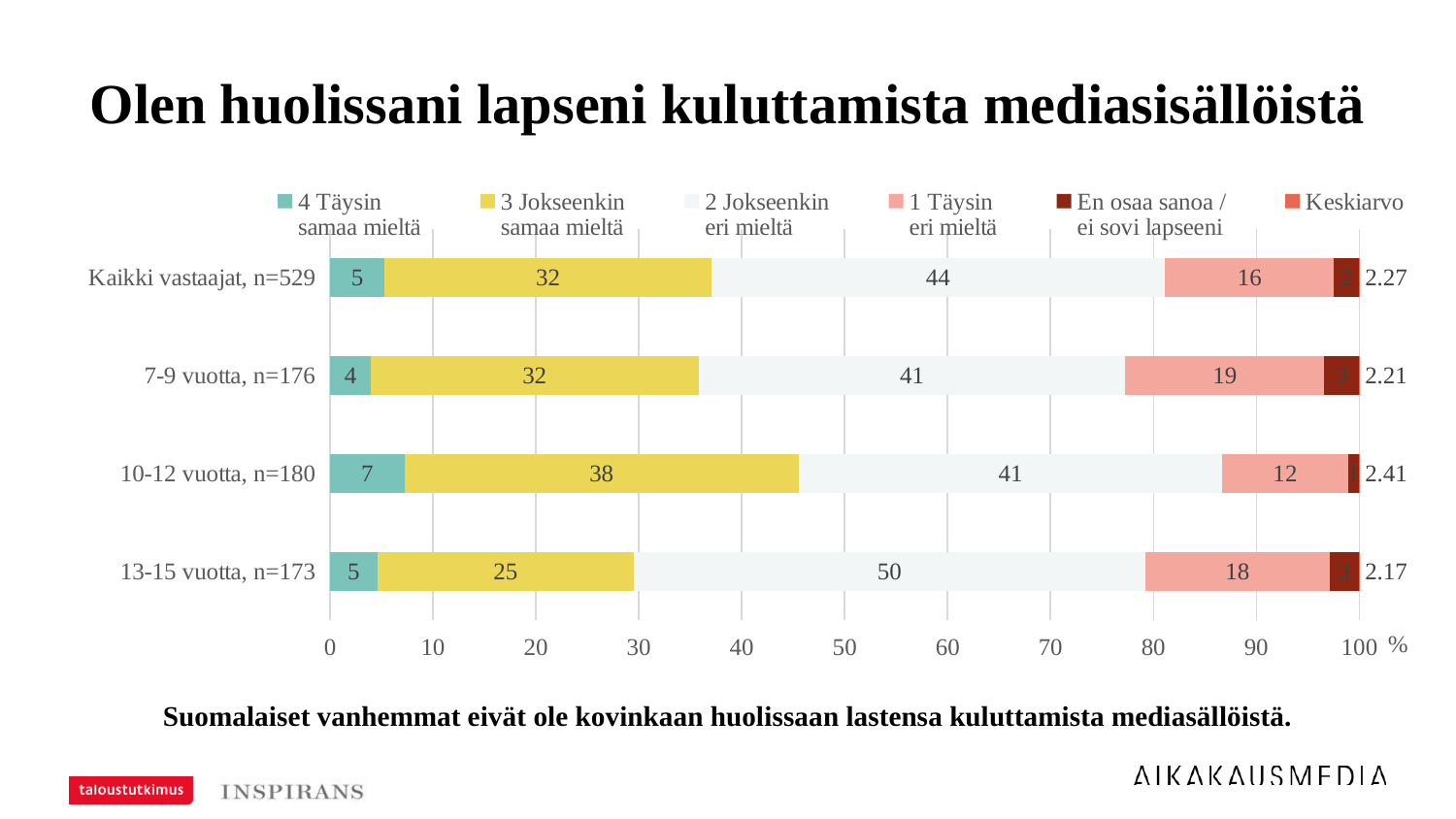
What is the Keskiarvo value for '10-12 vuotta, n=180'? 2.41 Which category has the lowest value for '3 Jokseenkin samaa mieltä'? 13-15 vuotta, n=173 How many series does the legend list? 6 What is the value of '3 Jokseenkin samaa mieltä' for 'Kaikki vastaajat, n=529'? 32 What is the title of the chart? Olen huolissani lapseni kuluttamista mediasisällöistä How many categories (respondent groups) are shown on the chart? 4 Which category has the highest Keskiarvo value? 10-12 vuotta, n=180 What is the value of '1 Täysin eri mieltä' for '7-9 vuotta, n=176'? 19 What is the value of '2 Jokseenkin eri mieltä' for '13-15 vuotta, n=173'? 50 What is the difference between the '2 Jokseenkin eri mieltä' values for '13-15 vuotta, n=173' and '7-9 vuotta, n=176'? 9 What type of chart is shown on the slide? stacked bar chart Which is larger: the '4 Täysin samaa mieltä' value for '10-12 vuotta, n=180' or for '7-9 vuotta, n=176'? 10-12 vuotta, n=180